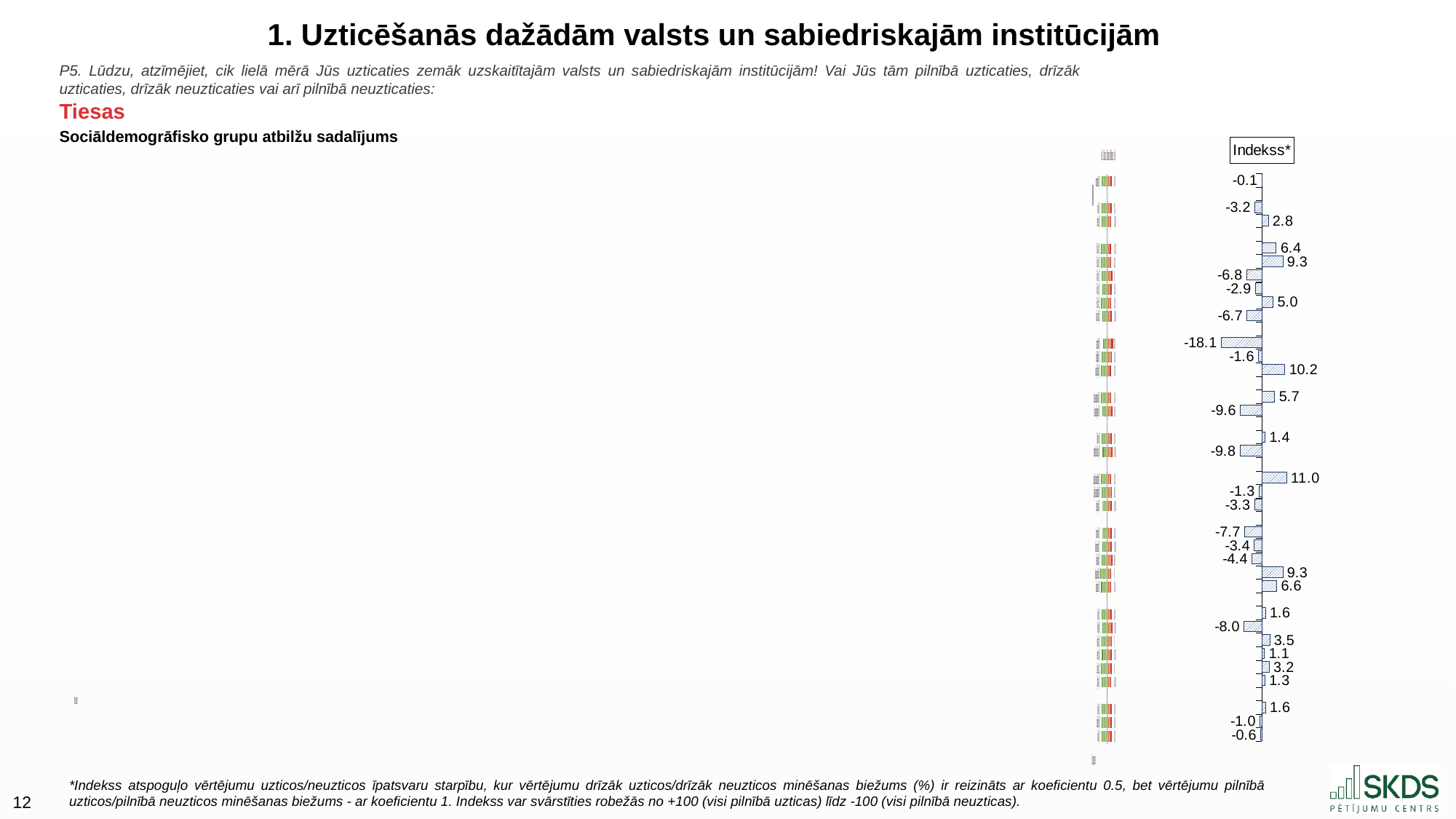
In the Indekss* chart, which is larger: the bar labelled 10.2 or the bar labelled 11.0? 11.0 What is the difference between the highest value (11.0) and the lowest value (-18.1) in the Indekss* chart? 29.1 What is the value of the topmost bar in the Indekss* chart? -0.1 What is the title shown above the chart on the right of the slide? Indekss* In the Indekss* chart, what is the lowest value shown? -18.1 What is the value of the bottommost bar in the Indekss* chart? -0.6 In the Indekss* chart, how many bars have a value greater than 10? 2 In the Indekss* chart, what is the highest value shown? 11.0 What kind of chart is the Indekss* chart on the right of the slide? bar chart Which institution (shown in red above the chart) does this slide's chart refer to? Tiesas